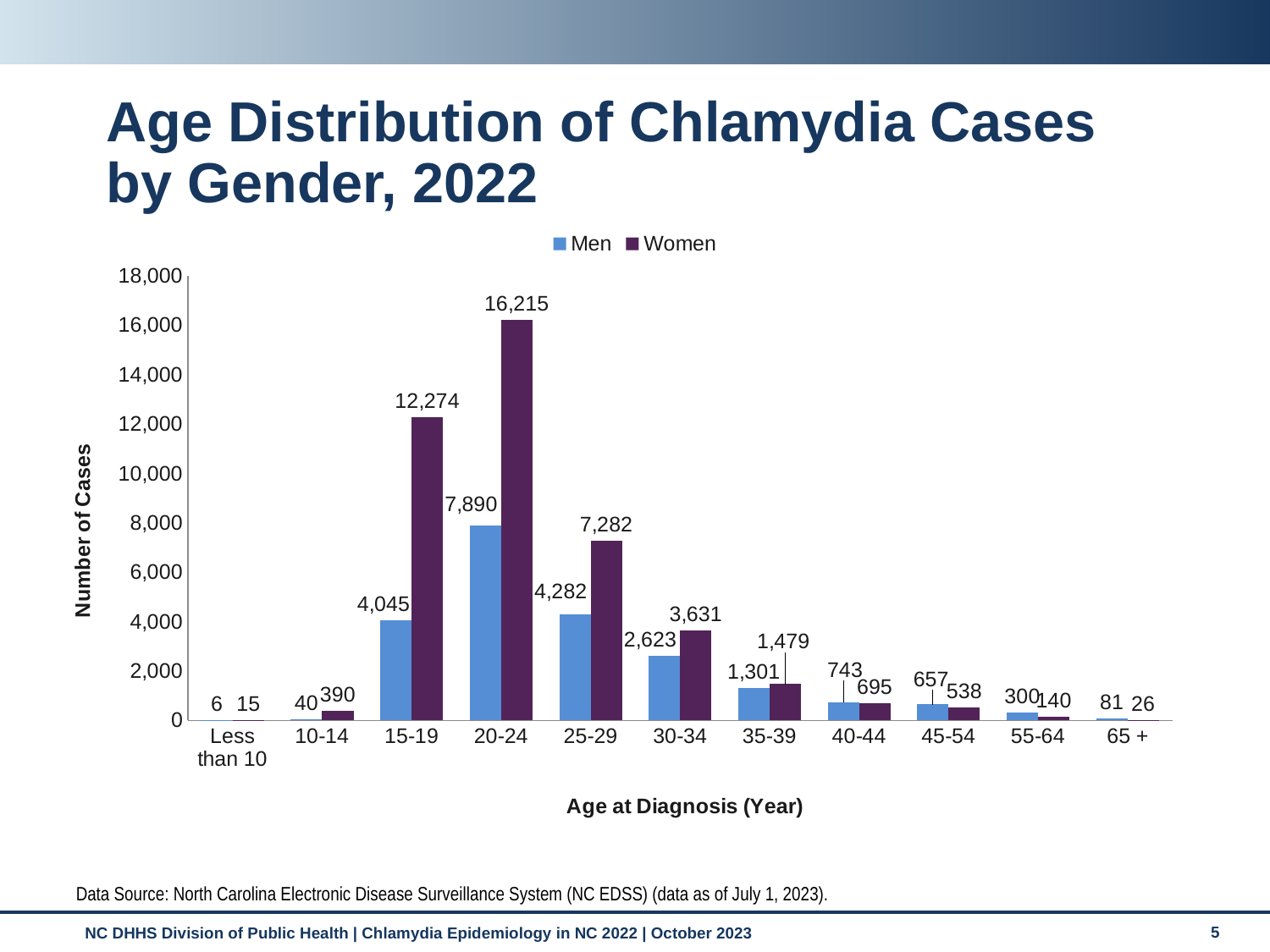
Which age group has the lowest number of cases among men? Less than 10 How many series does the legend list? 2 How many chlamydia cases were reported among men aged 15-19? 4,045 What is the number of cases for men in the 65 + age group? 81 What is the difference between women and men cases in the 15-19 age group? 8,229 How many age groups are shown on the x axis? 11 What kind of chart is shown on the slide? Bar chart Which age group has the highest number of cases among women? 20-24 In the 40-44 age group, which gender has more cases? Men How many chlamydia cases were reported among women aged 20-24? 16,215 Is the value for men aged 20-24 greater or less than 8,000? less What is the label of the y axis? Number of Cases